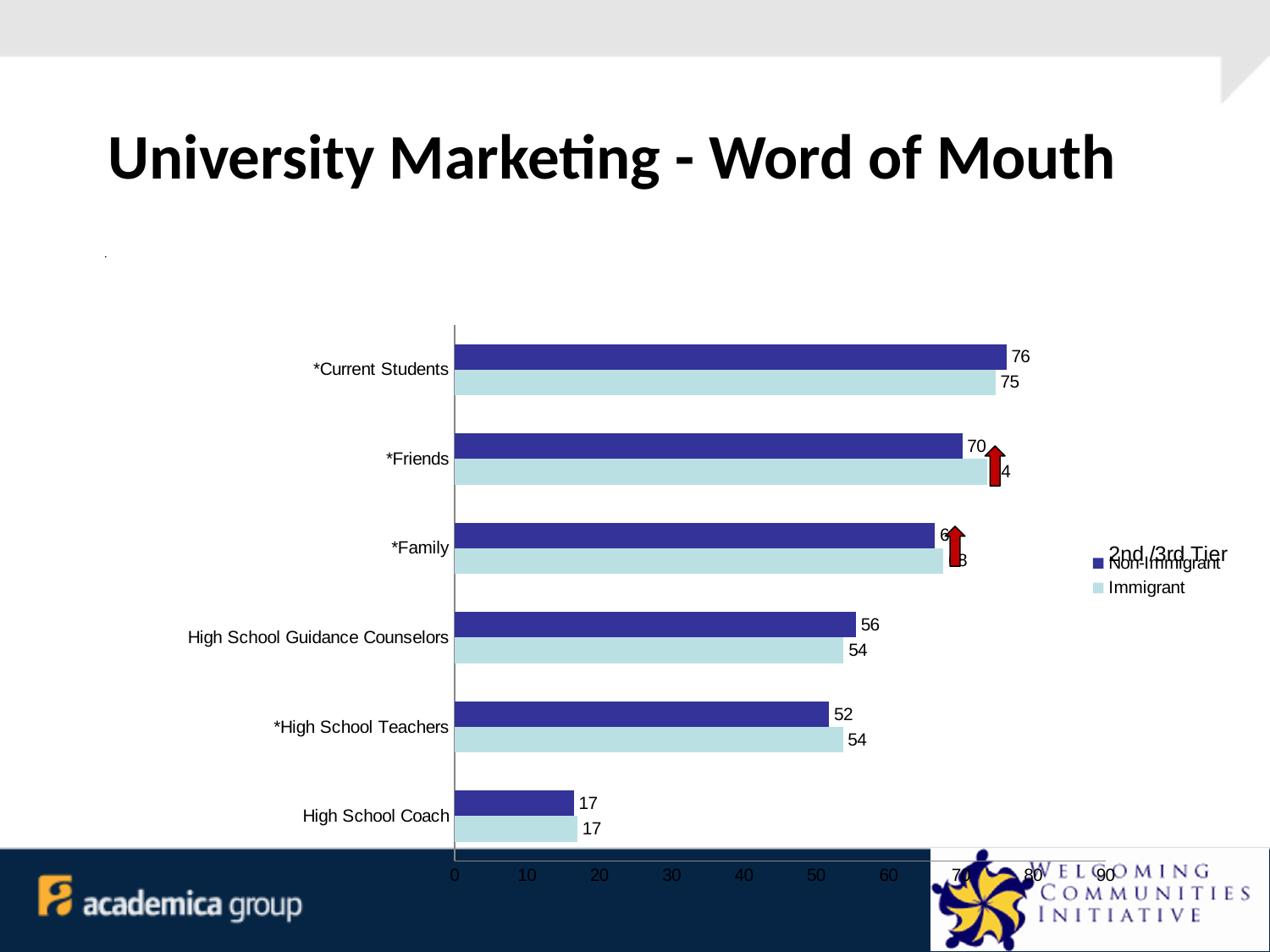
What type of chart is shown on the slide? Bar chart What is the Non-Immigrant value for *High School Teachers? 52 For *High School Teachers, which is larger: the Non-Immigrant value or the Immigrant value? Immigrant What is the Non-Immigrant value for *Current Students? 76 Which category has the lowest Non-Immigrant value? High School Coach What is the Immigrant value for High School Guidance Counselors? 54 What is the difference between the Non-Immigrant and Immigrant values for High School Guidance Counselors? 2 What is the Immigrant value for *Current Students? 75 Which category has the highest Immigrant value? *Current Students How many categories are shown on the chart? 6 What is the Non-Immigrant value for *Friends? 70 Is the Immigrant value for *Friends greater or less than 70? greater